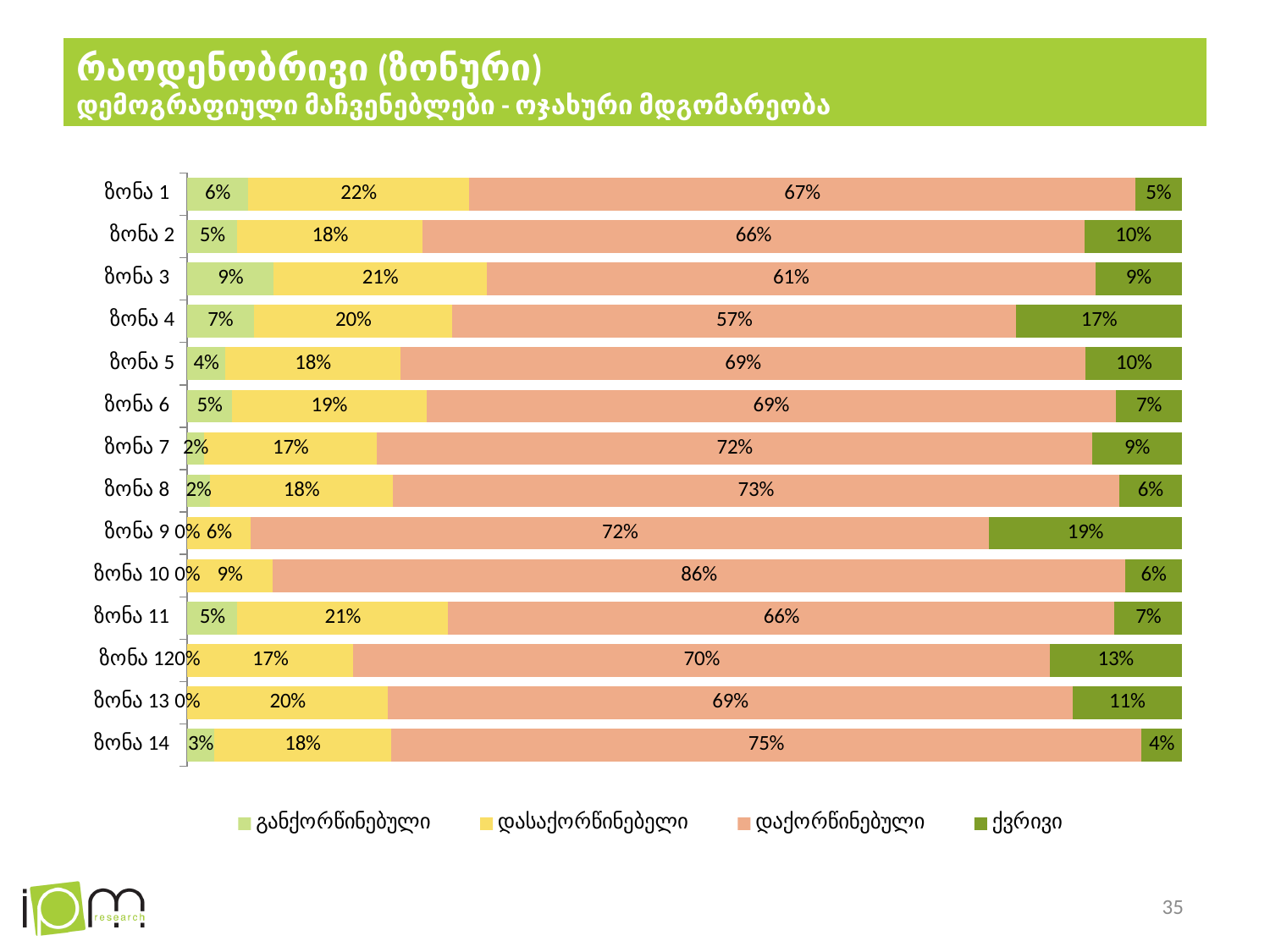
Which zone has the lowest value for დაქორწინებული? ზონა 4 Which zone has the highest value for დაქორწინებული? ზონა 10 What is the value of ქვრივი for ზონა 4? 17% Which is larger: the ქვრივი value for ზონა 2 or for ზონა 6? ზონა 2 What kind of chart is shown on the slide? Stacked bar chart Which zone has the highest value for ქვრივი? ზონა 9 How many series does the legend list? 4 What is the difference between the დაქორწინებული values for ზონა 10 and ზონა 3? 25% How many zones (categories) are plotted on the chart? 14 Which series is shown in dark green in the legend? ქვრივი What is the value of დაქორწინებული for ზონა 10? 86% What is the value of დასაქორწინებელი for ზონა 1? 22%